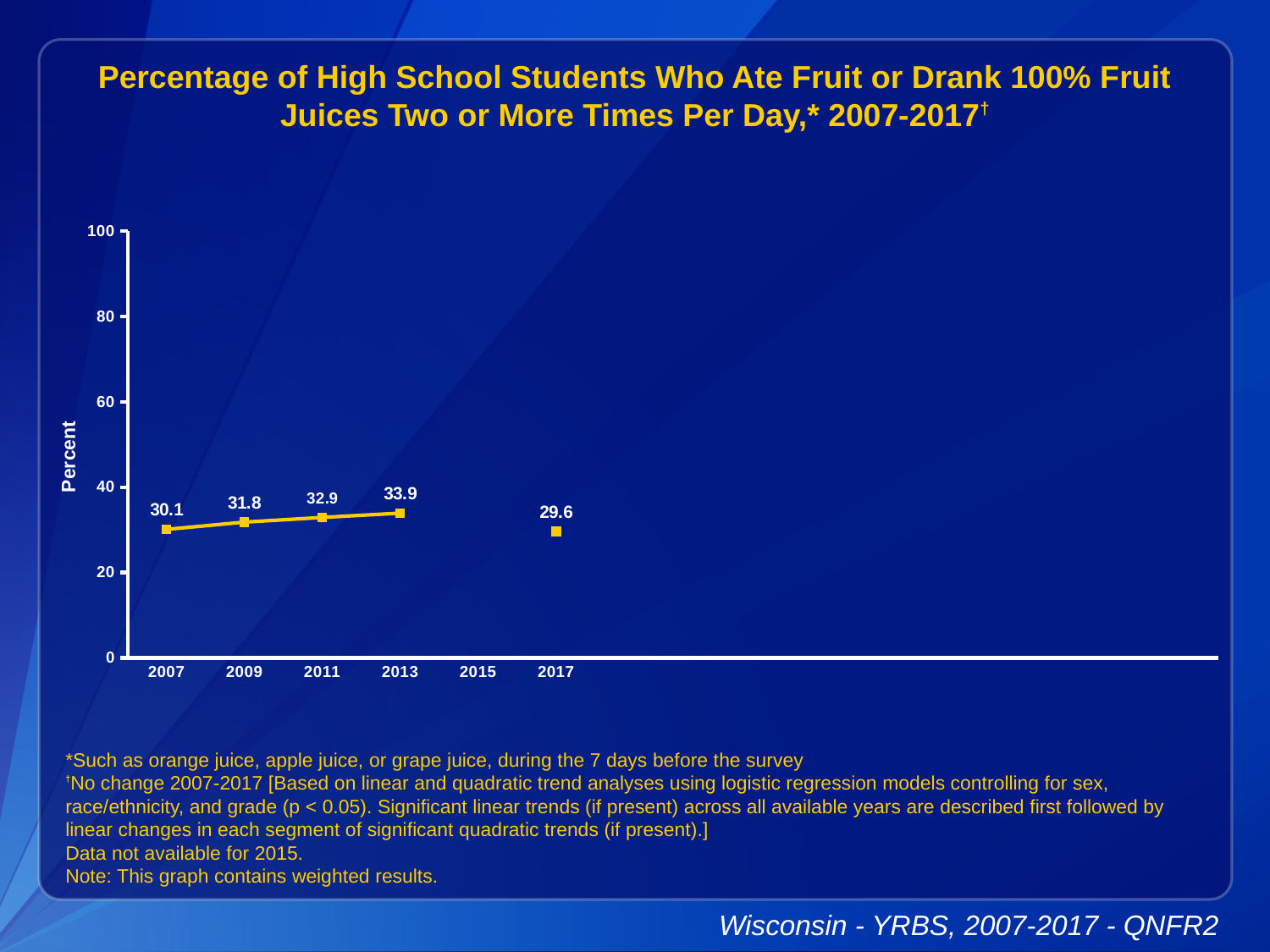
Which is larger, the value for 2009 or the value for 2017? 2009 What is the value plotted for 2011? 32.9 What is the value plotted for 2017? 29.6 How many years have a data point plotted on the chart? 5 Which year has the highest plotted value? 2013 What kind of chart is shown on the slide? line chart Is the value for 2013 greater or less than 40? less Which year has the lowest plotted value? 2017 Do the values rise or fall from 2007 to 2013? rise What percentage of high school students ate fruit or drank 100% fruit juices two or more times per day in 2007? 30.1 What is the value plotted for 2013? 33.9 What is the difference between the 2013 value and the 2007 value? 3.8